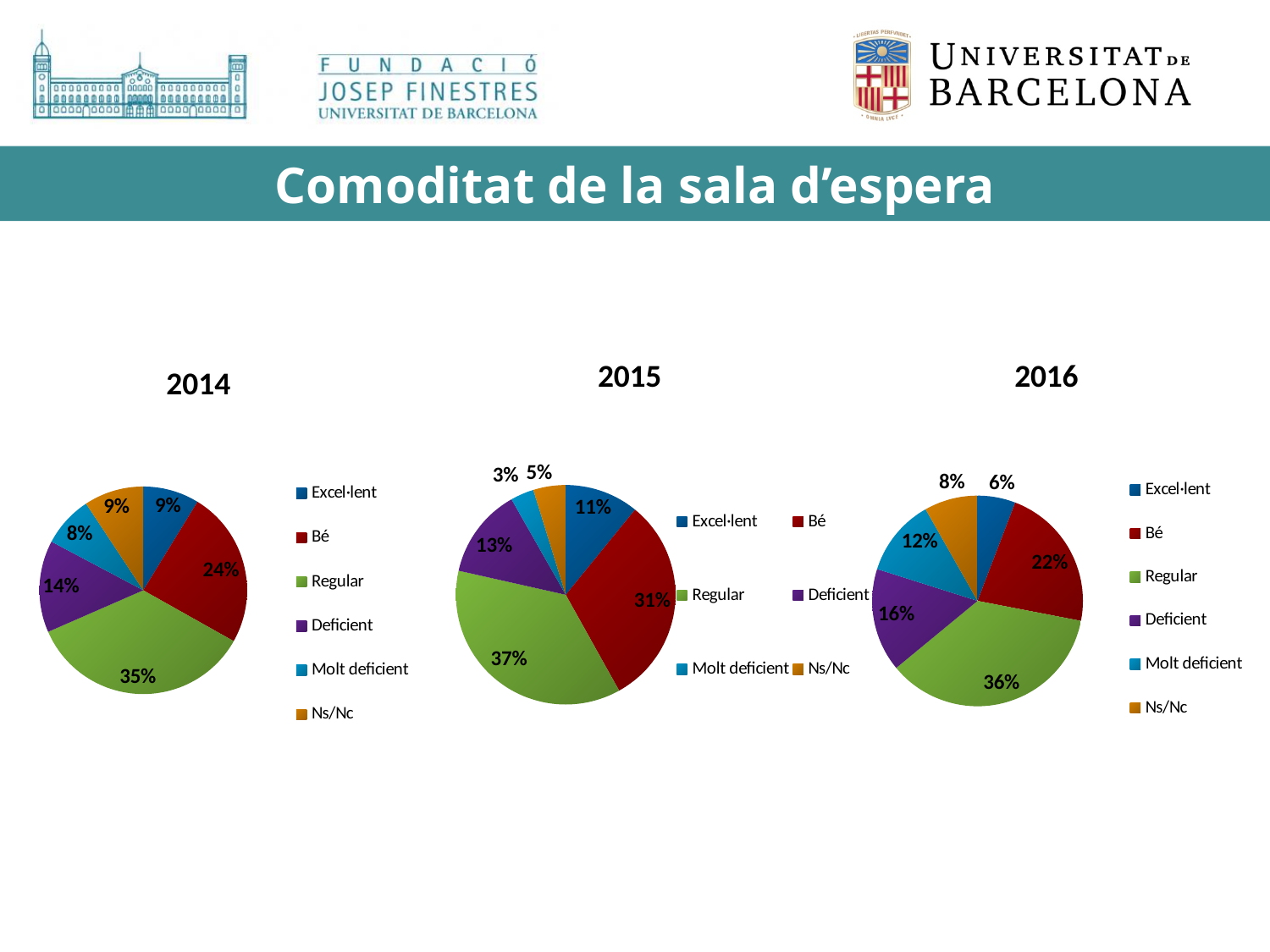
How many categories does the legend of the 2016 pie chart list? 6 In the 2014 pie chart, which category has the smallest slice? Molt deficient What is the title of the slide containing the three pie charts? Comoditat de la sala d'espera In the 2015 pie chart, what share is labelled for Bé? 31% Which is larger in the 2014 pie chart: the Deficient slice or the Ns/Nc slice? Deficient In the 2014 pie chart, what share is labelled for Regular? 35% In the 2015 pie chart, which category has the smallest slice? Molt deficient What type of chart is used for the 2015 data? Pie chart In the 2016 pie chart, what share is labelled for Molt deficient? 12% In the 2016 pie chart, which category has the largest slice? Regular In the 2016 pie chart, what is the difference between the Bé and Excel·lent shares? 16% In the 2015 pie chart, what is the difference between the Regular and Deficient shares? 24%